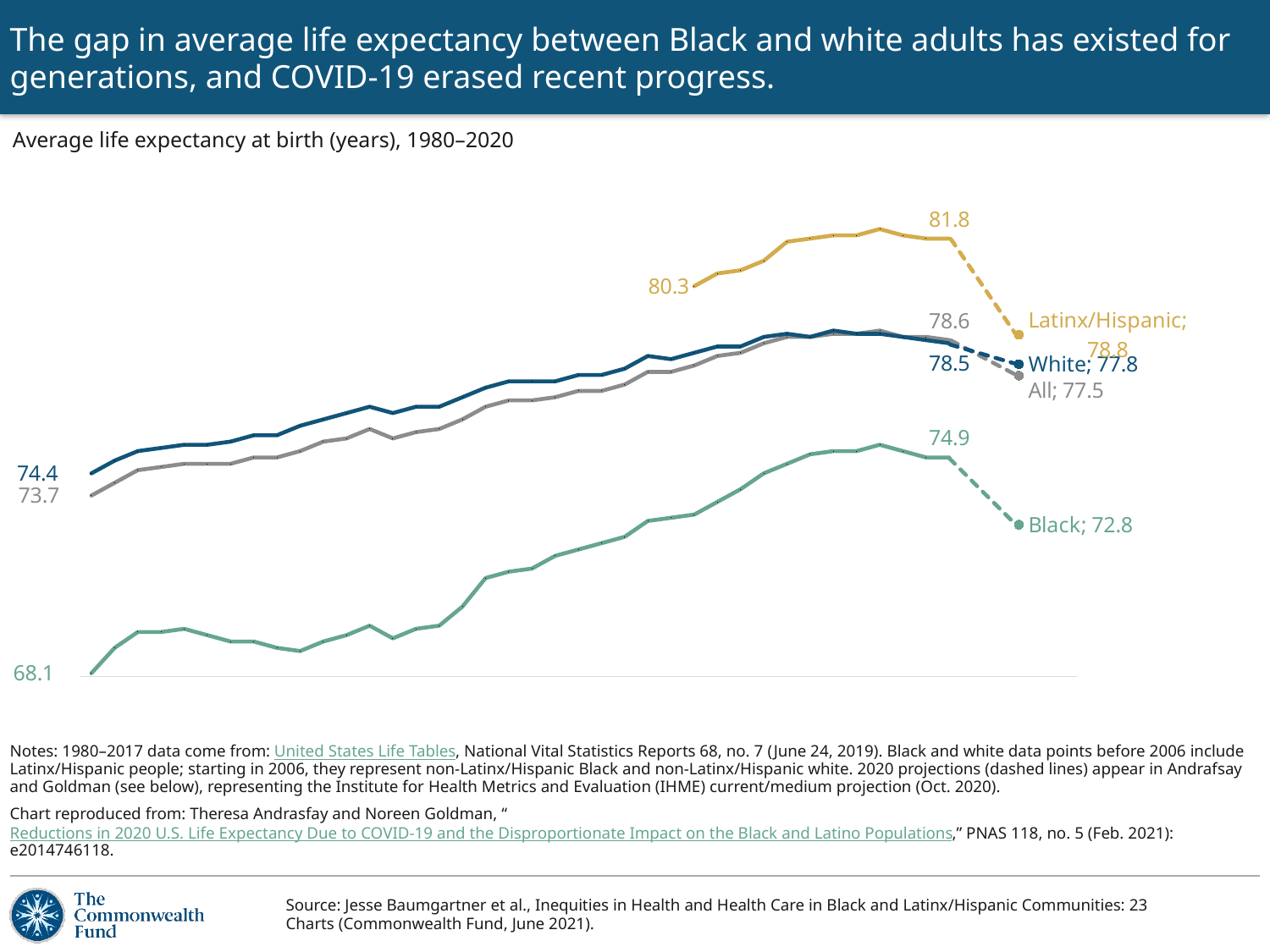
Which group has the highest projected life expectancy in 2020? Latinx/Hispanic What is the projected 2020 average life expectancy for white adults? 77.8 What is the projected 2020 average life expectancy for Latinx/Hispanic adults? 78.8 By how much does the Latinx/Hispanic life expectancy fall from its labeled peak of 81.8 to the 2020 projection of 78.8? 3.0 What is the projected 2020 average life expectancy for the 'All' series? 77.5 What is the projected 2020 average life expectancy for Black adults? 72.8 What kind of chart is shown on the slide? Line chart What was the average life expectancy for Black adults at the start of the series in 1980? 68.1 Which group has the lowest projected life expectancy in 2020? Black What is the difference between the projected 2020 life expectancy for white adults (77.8) and Black adults (72.8)? 5.0 What is the subtitle describing the chart's measure and time period? Average life expectancy at birth (years), 1980–2020 How many lines (series) are plotted on the chart? 4